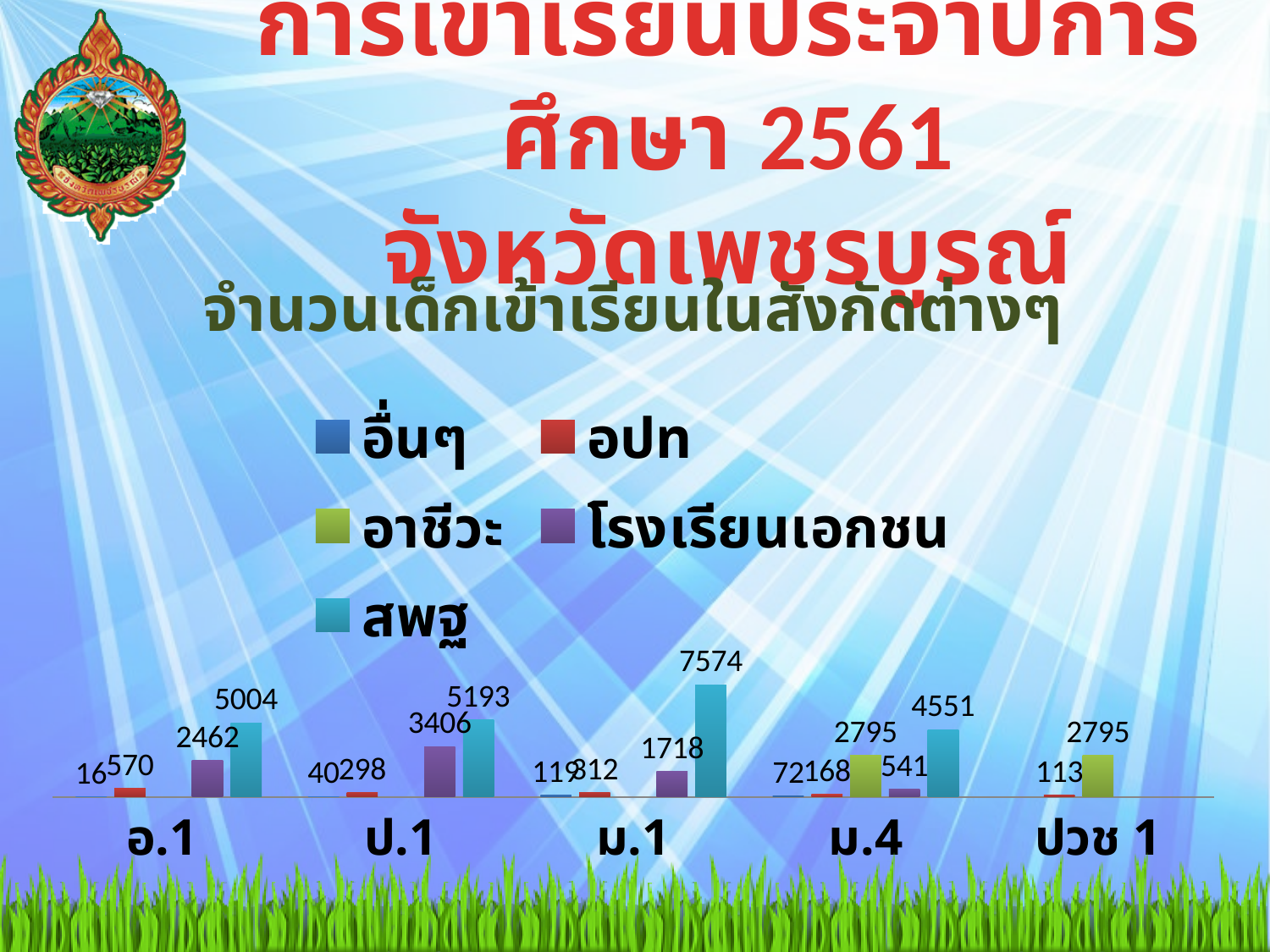
Among อ.1, ป.1, ม.1 and ม.4, which category has the lowest value for สพฐ? ม.4 What kind of chart is shown on the slide? bar chart How many categories are shown on the x axis? 5 Which category has the highest value for สพฐ? ม.1 What is the difference between the สพฐ values for ป.1 and อ.1? 189 What is the value for สพฐ in the ม.1 category? 7574 What is the value for อาชีวะ in the ปวช 1 category? 2795 What is the value for อปท in the อ.1 category? 570 How many series does the legend list? 5 Which is larger, the โรงเรียนเอกชน value for ป.1 or for อ.1? ป.1 What is the difference between the สพฐ and โรงเรียนเอกชน values in the ม.1 category? 5856 What is the value for โรงเรียนเอกชน in the ม.4 category? 541